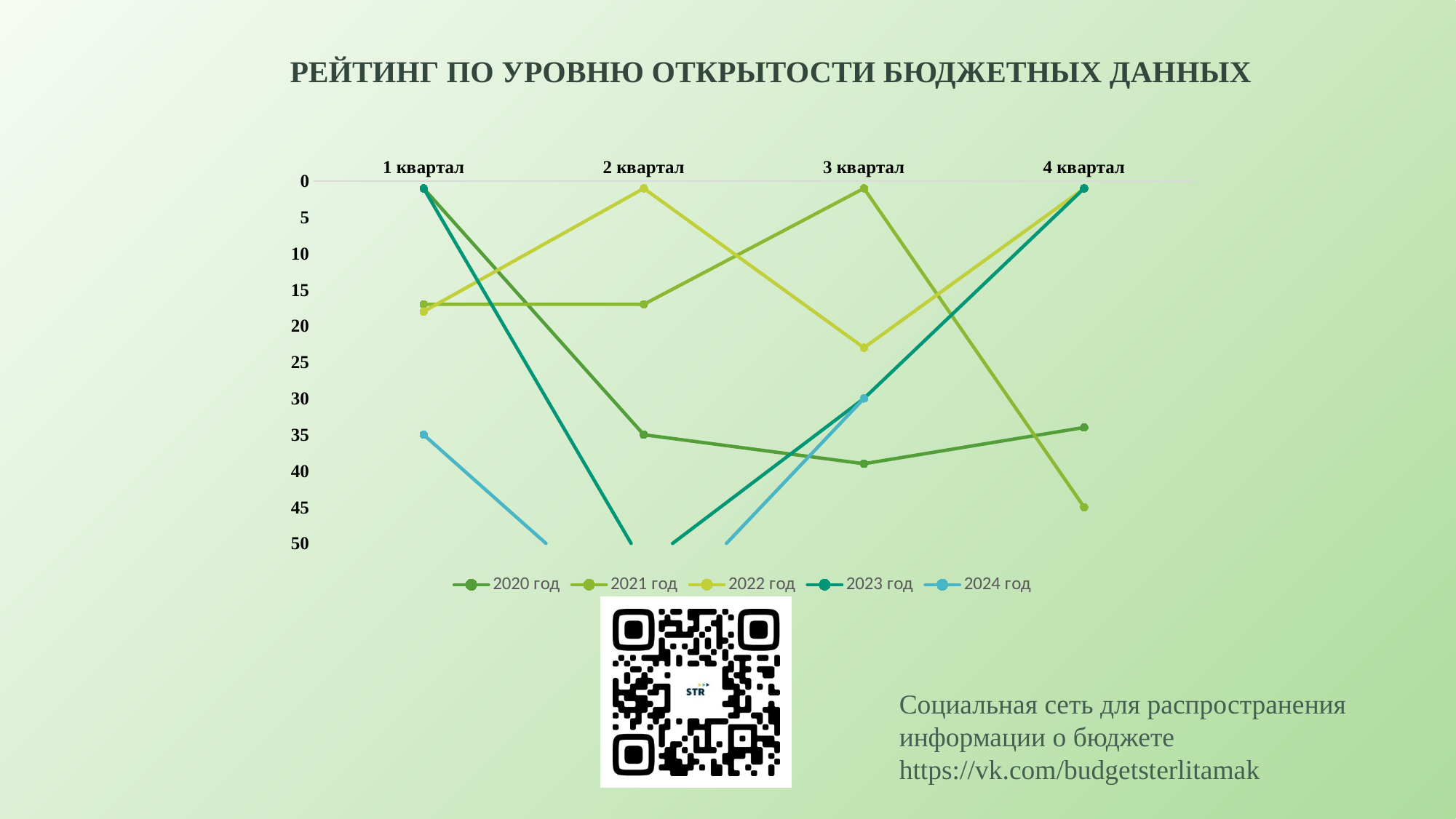
What is the title of the chart? РЕЙТИНГ ПО УРОВНЮ ОТКРЫТОСТИ БЮДЖЕТНЫХ ДАННЫХ Is the value for 2022 год in 2 квартал greater or less than 5? less Is the value for 2020 год in 2 квартал greater or less than 30? greater Is the value for 2020 год in 3 квартал greater or less than 35? greater How many series does the legend list? 5 How many quarters (categories) are shown on the x axis? 4 What kind of chart is shown on the slide? line chart Which series is shown in light blue in the legend? 2024 год